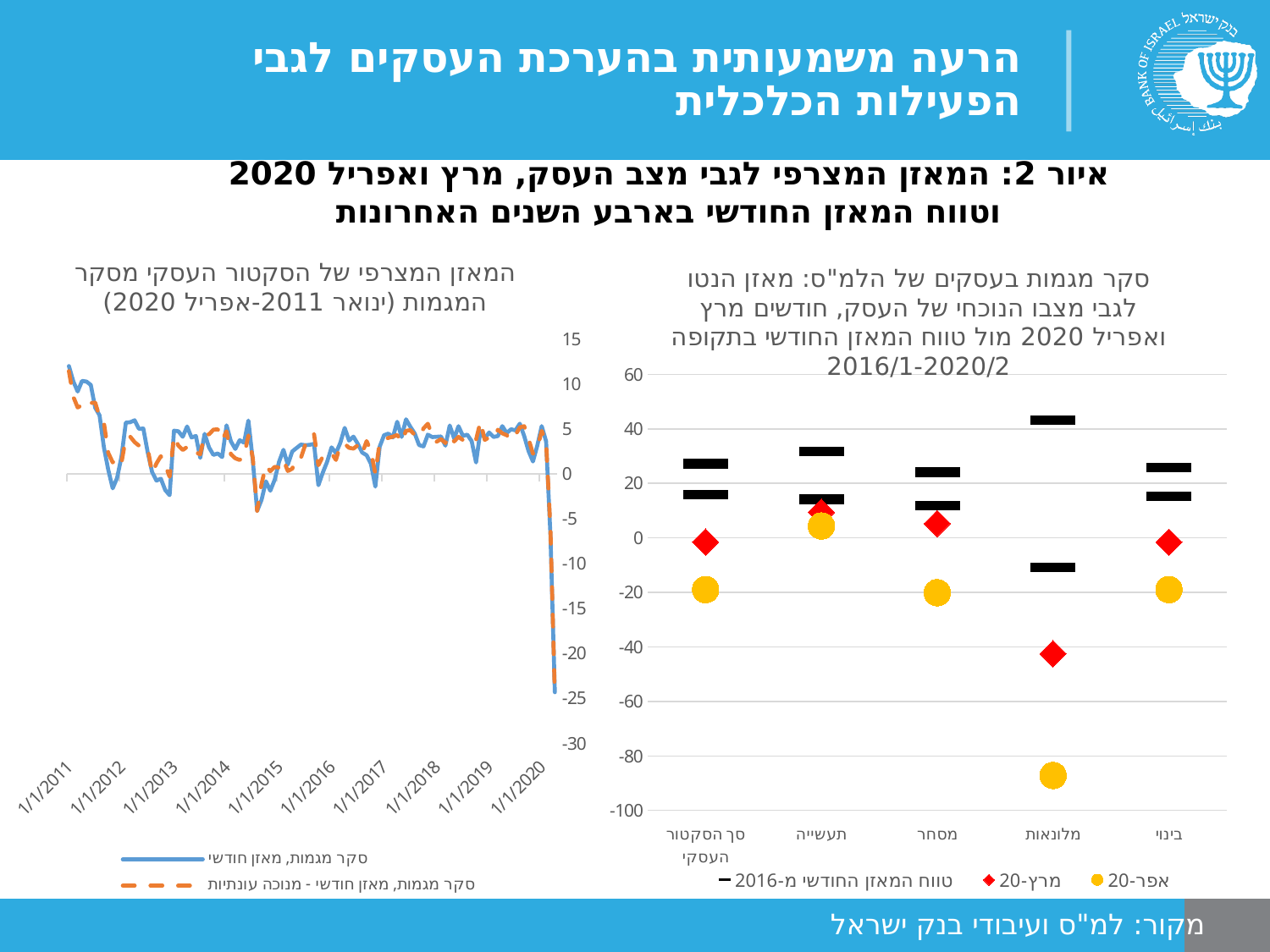
What kind of chart is the left-hand chart? line chart In the left-hand chart, how many series does the legend list? 2 In the right-hand chart, is the אפר-20 value for מלונאות greater or less than -80? less In the left-hand chart, is the final value of the blue line (at the far right, around 2020) greater or less than -20? less In the right-hand chart, for מסחר, which is larger: the מרץ-20 value or the אפר-20 value? מרץ-20 In the right-hand chart, is the מרץ-20 value for תעשייה greater or less than 0? greater In the right-hand chart, how many series does the legend list? 3 In the right-hand chart, which category has the lowest value for אפר-20? מלונאות In the right-hand chart, which category has the highest value for אפר-20? תעשייה In the right-hand chart, which series is shown with red diamond markers? מרץ-20 In the right-hand chart, how many categories are shown on the x axis? 5